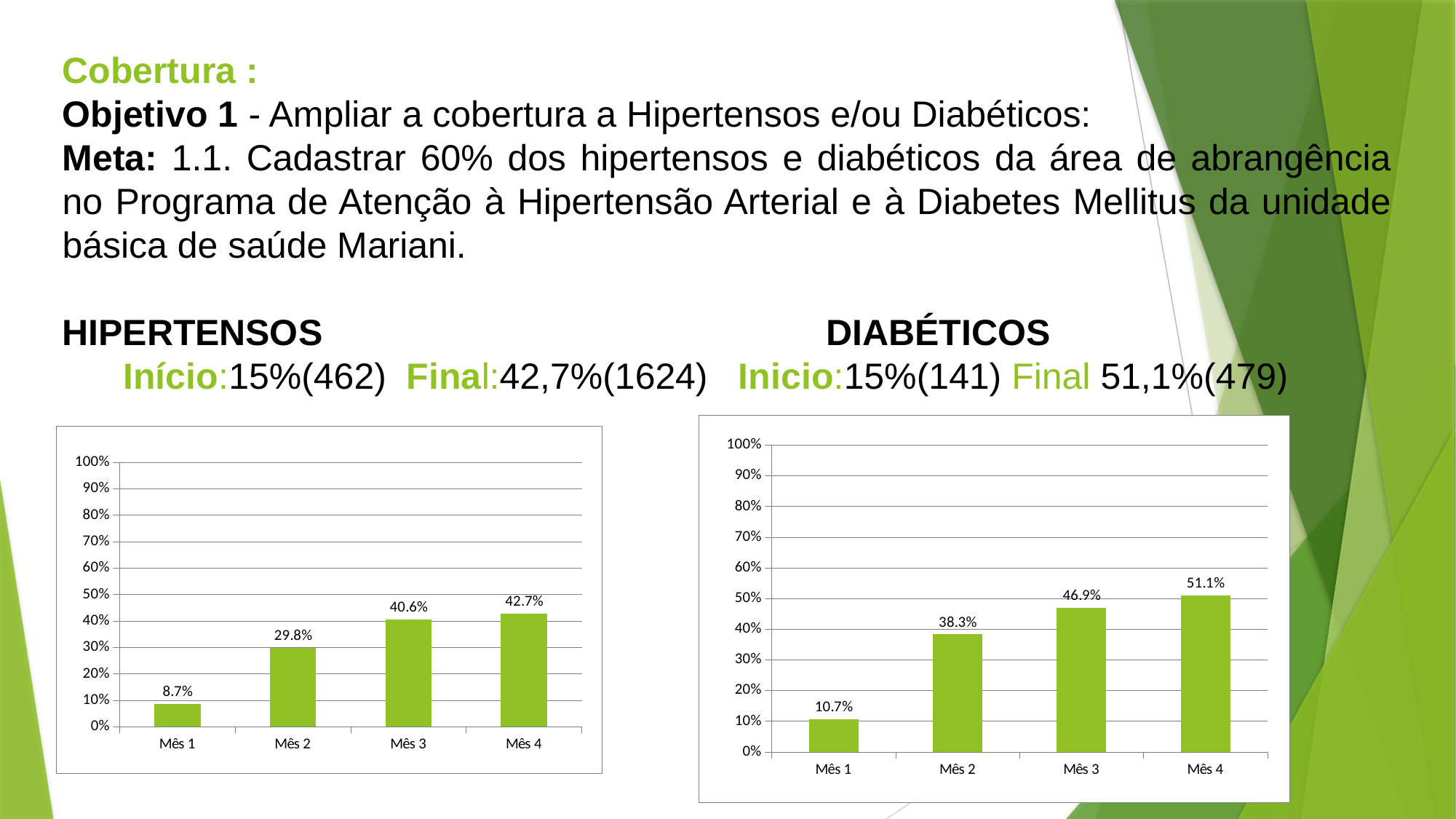
In the left chart (HIPERTENSOS), is the value for Mês 1 greater or less than 10%? less In the right chart (DIABÉTICOS), which month has the lowest value? Mês 1 Which is larger: the Mês 2 value in the left chart (HIPERTENSOS) or the Mês 2 value in the right chart (DIABÉTICOS)? Right chart (DIABÉTICOS), 38.3% In the right chart (DIABÉTICOS), what is the value for Mês 3? 46.9% In the left chart (HIPERTENSOS), what is the value for Mês 2? 29.8% How many months are shown on the x axis of the left chart (HIPERTENSOS)? 4 In the right chart (DIABÉTICOS), is the value for Mês 4 greater or less than 50%? greater In the right chart (DIABÉTICOS), what is the difference between the values for Mês 4 and Mês 3? 4.2 percentage points In the left chart (HIPERTENSOS), which month has the highest value? Mês 4 In the left chart (HIPERTENSOS), what is the difference between the values for Mês 4 and Mês 1? 34.0 percentage points In the left chart (HIPERTENSOS), do the values rise or fall from Mês 1 to Mês 4? Rise What type of chart is the right chart (DIABÉTICOS)? Bar chart